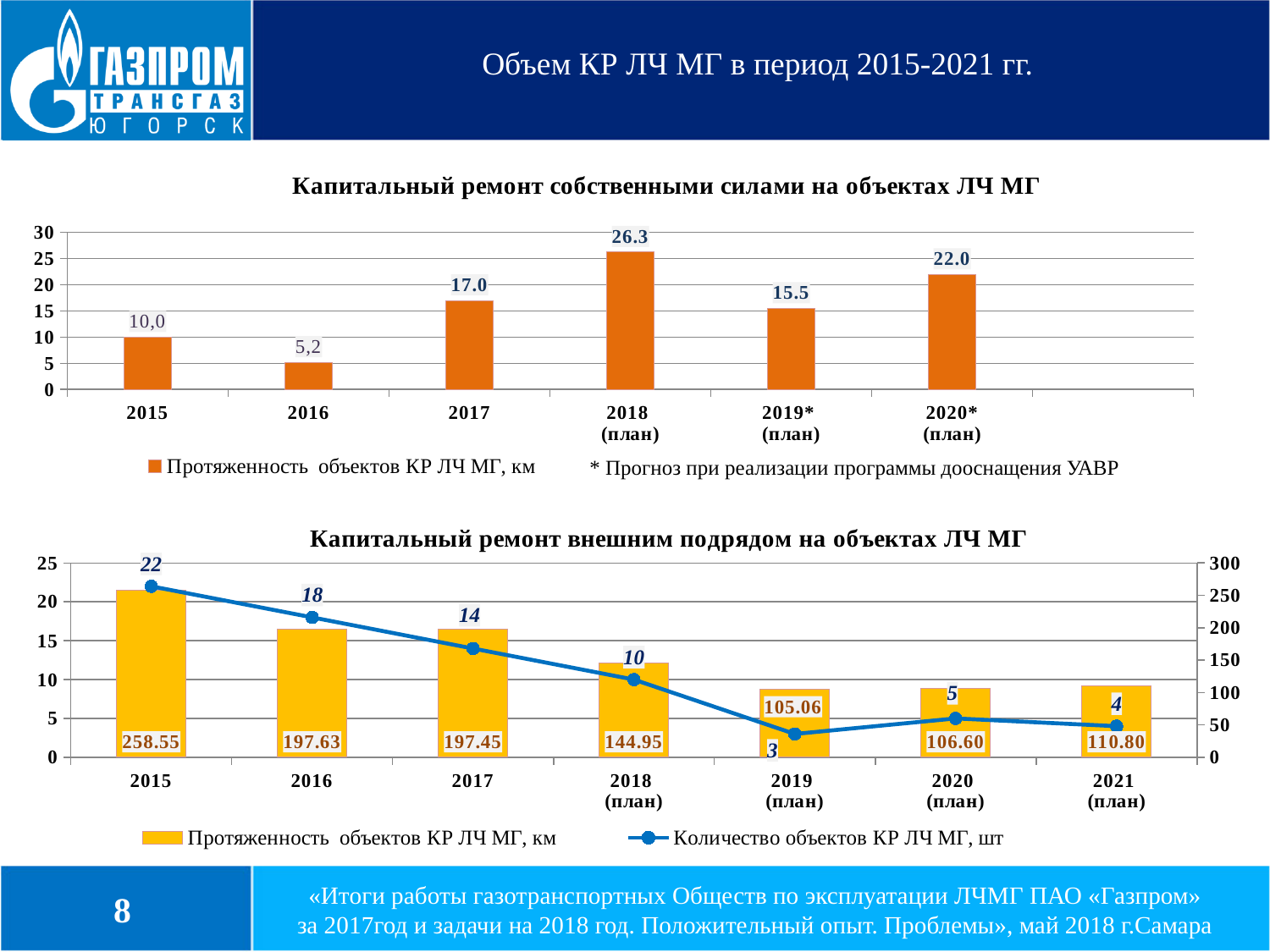
In the chart 'Капитальный ремонт собственными силами на объектах ЛЧ МГ', what is the difference between the values for 2020* (план) and 2019* (план)? 6.5 In the chart 'Капитальный ремонт собственными силами на объектах ЛЧ МГ', what is the value for 2018 (план)? 26.3 In the chart 'Капитальный ремонт внешним подрядом на объектах ЛЧ МГ', what is the number of objects (Количество объектов КР ЛЧ МГ, шт) for 2019 (план)? 3 In the chart 'Капитальный ремонт внешним подрядом на объектах ЛЧ МГ', does the number of objects rise or fall from 2015 to 2019 (план)? fall In the chart 'Капитальный ремонт внешним подрядом на объектах ЛЧ МГ', which is larger: the length of objects for 2016 or for 2017? 2016 In the chart 'Капитальный ремонт собственными силами на объектах ЛЧ МГ', which year has the lowest value? 2016 In the chart 'Капитальный ремонт собственными силами на объектах ЛЧ МГ', how many years are shown on the x axis? 6 What kind of chart is 'Капитальный ремонт собственными силами на объектах ЛЧ МГ'? bar chart In the chart 'Капитальный ремонт внешним подрядом на объектах ЛЧ МГ', what is the length of objects (Протяженность объектов КР ЛЧ МГ, км) for 2015? 258.55 In the chart 'Капитальный ремонт собственными силами на объектах ЛЧ МГ', which year has the highest value? 2018 (план) In the chart 'Капитальный ремонт внешним подрядом на объектах ЛЧ МГ', how many series does the legend list? 2 In the chart 'Капитальный ремонт внешним подрядом на объектах ЛЧ МГ', what is the difference in the number of objects between 2015 and 2016? 4